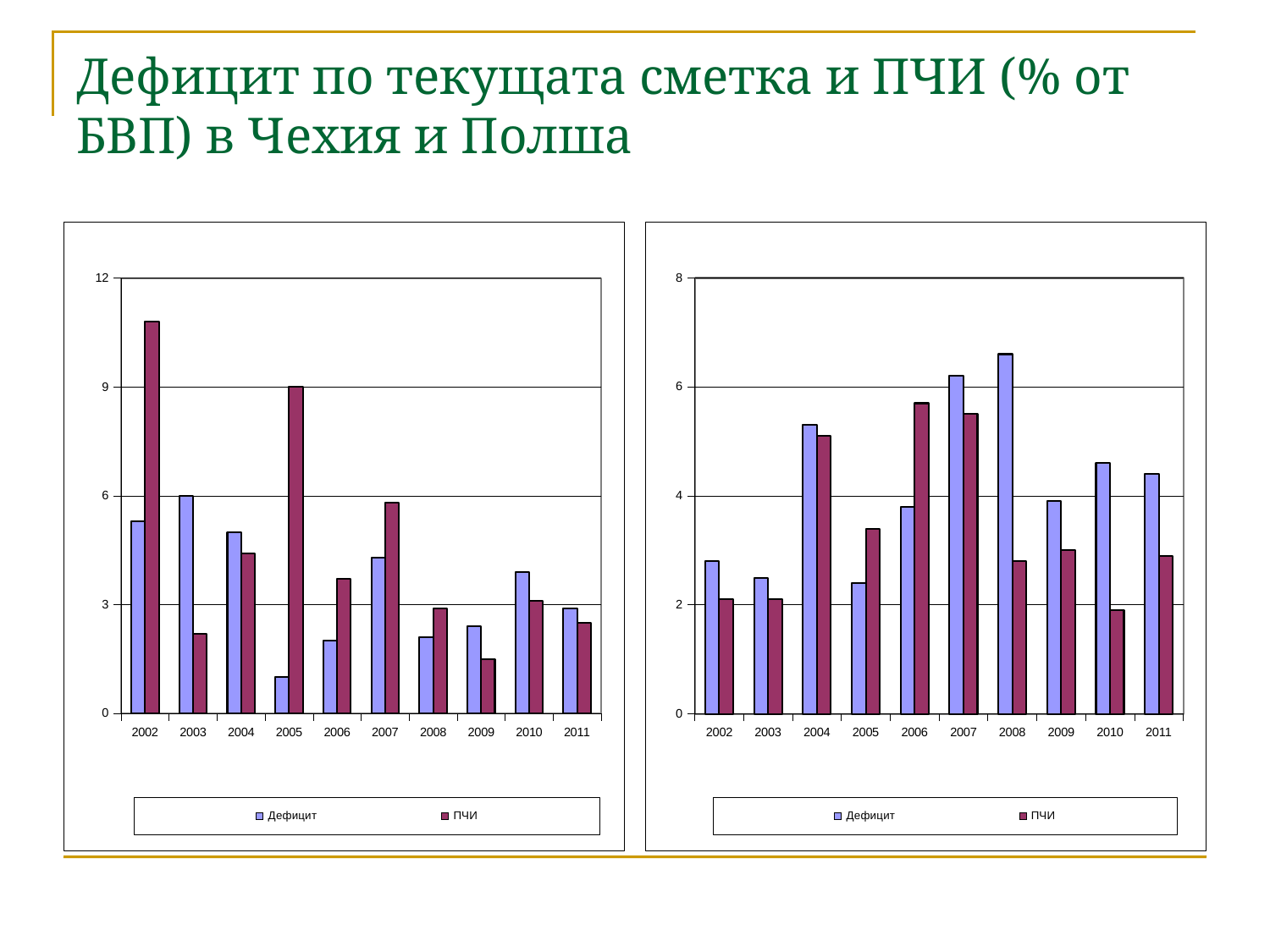
What are the two legend entries of the left chart? Дефицит and ПЧИ In the left chart, which is larger for 2007: Дефицит or ПЧИ? ПЧИ In the left chart, is the ПЧИ value for 2002 greater or less than 9? greater How many years are shown on the x axis of the left chart? 10 In the left chart, which year has the highest ПЧИ value? 2002 In the right chart, is the Дефицит value for 2008 greater or less than 6? greater How many series does the legend of the right chart list? 2 In the right chart, which year has the highest Дефицит value? 2008 What kind of chart is the left chart on the slide? bar chart In the right chart, which is larger for 2006: Дефицит or ПЧИ? ПЧИ In the right chart, is the ПЧИ value for 2005 greater or less than 4? less In the left chart, which year has the lowest Дефицит value? 2005